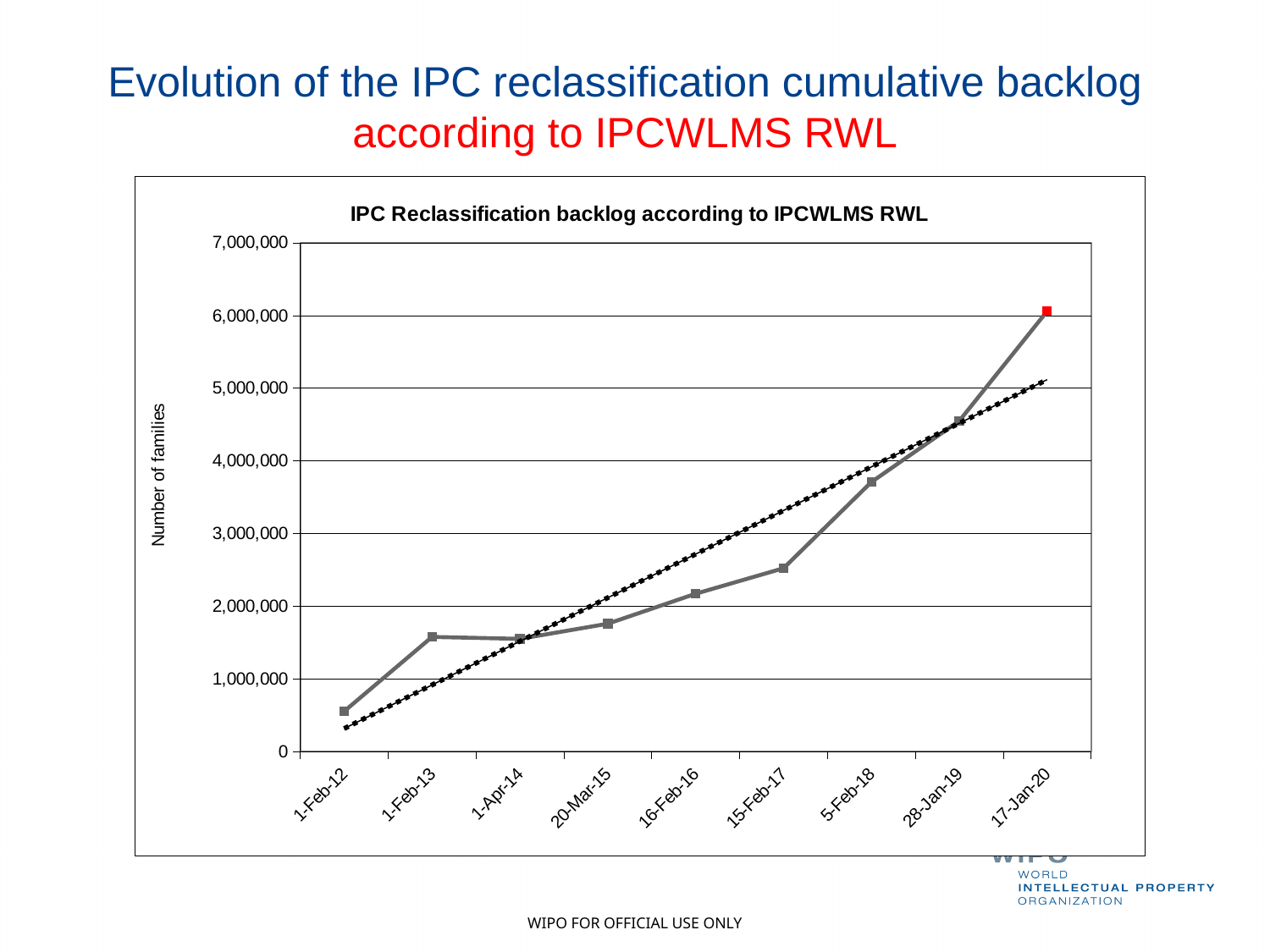
Which date has the lowest backlog value in the chart? 1-Feb-12 What kind of chart is shown on the slide? line chart Is the value for 1-Feb-12 greater or less than 1,000,000? less Is the value for 5-Feb-18 greater or less than 3,000,000? greater Overall, does the backlog rise or fall from 1-Feb-12 to 17-Jan-20? rise Which has the larger backlog value, 5-Feb-18 or 15-Feb-17? 5-Feb-18 Is the value for 28-Jan-19 greater or less than 4,000,000? greater How many dates are plotted along the x axis of the chart? 9 Which date has the highest backlog value in the chart? 17-Jan-20 What is the label of the vertical axis of the chart? Number of families